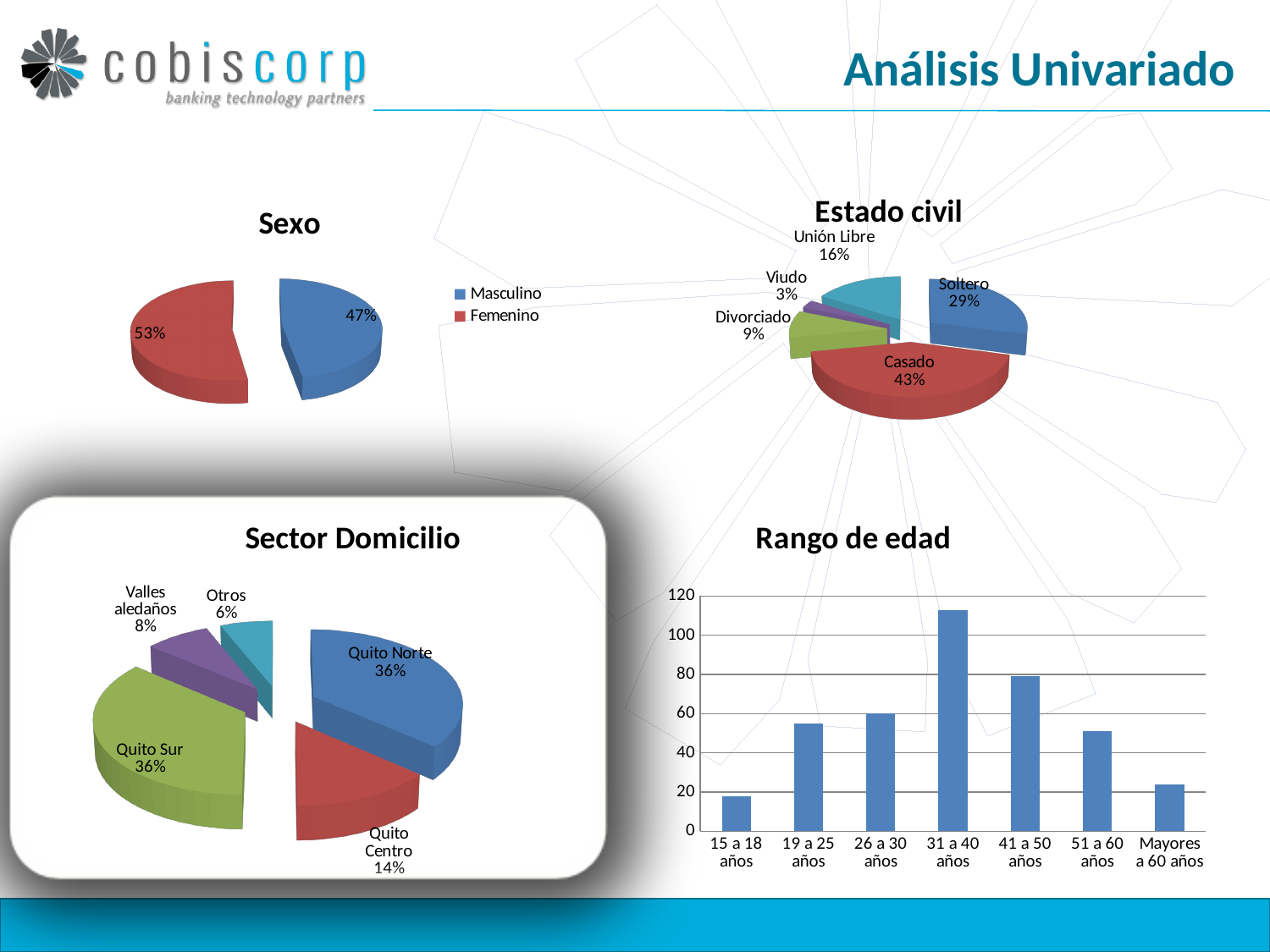
In the Sexo chart, which category is larger, Masculino or Femenino? Femenino In the Rango de edad chart, which age range has the lowest value? 15 a 18 años How many slices does the Estado civil pie chart have? 5 In the Sexo chart, what percentage is Femenino? 53% In the Sector Domicilio chart, what percentage is Quito Centro? 14% What kind of chart is Rango de edad? bar chart In the Sector Domicilio chart, what is the difference between Valles aledaños and Otros? 2% In the Rango de edad chart, which age range has the highest value? 31 a 40 años In the Estado civil chart, what percentage is Casado? 43% In the Estado civil chart, which category has the smallest share? Viudo In the Estado civil chart, what is the difference between Soltero and Unión Libre? 13% In the Rango de edad chart, is the value for 31 a 40 años greater or less than 100? greater